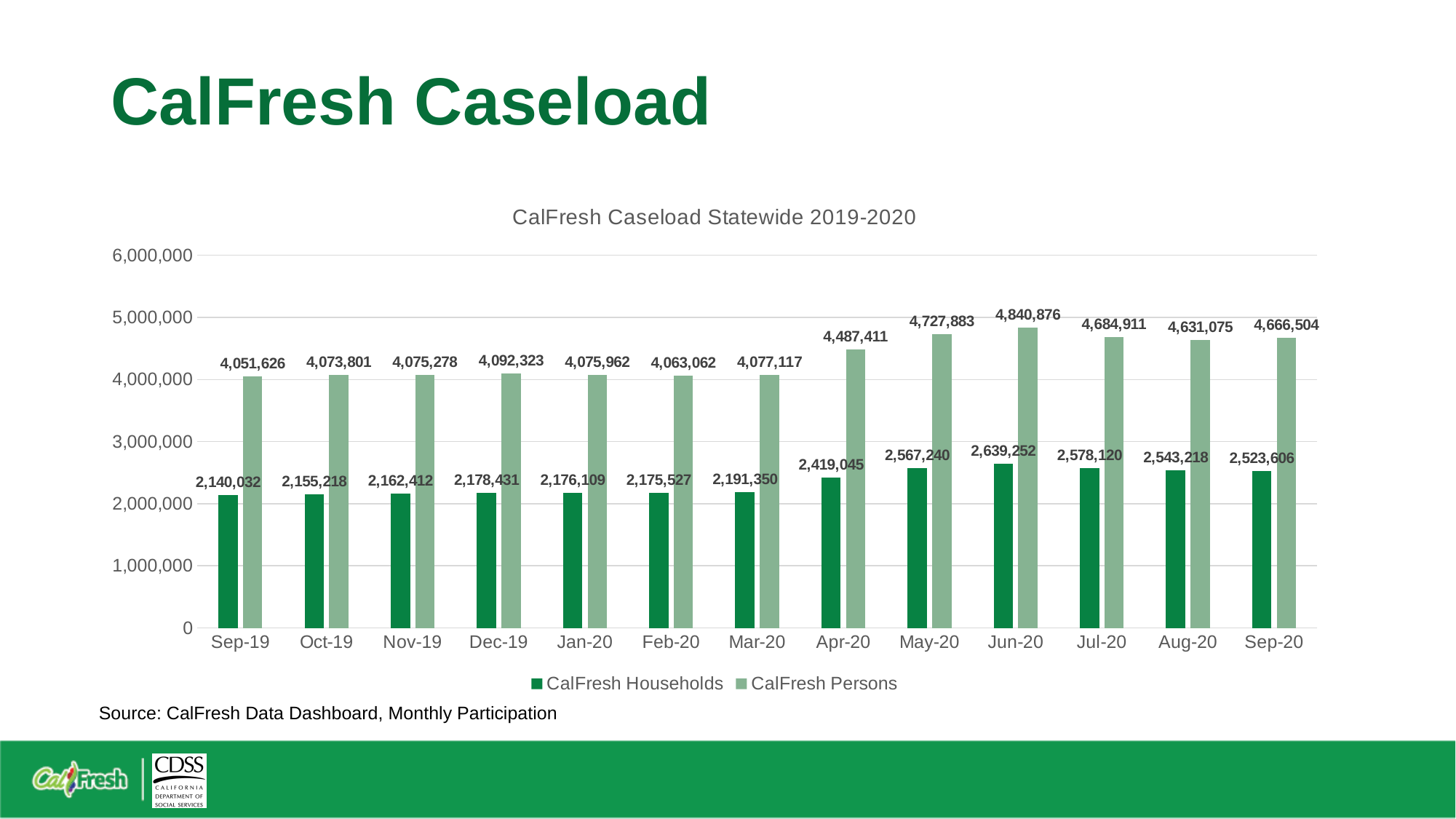
What is the value for CalFresh Households in Apr-20? 2,419,045 What is the title of the chart? CalFresh Caseload Statewide 2019-2020 What kind of chart is shown on the slide? Bar chart What is the value for CalFresh Persons in Jun-20? 4,840,876 How many series does the legend list? 2 Which month has the lowest value for CalFresh Households? Sep-19 Is the value for CalFresh Persons in Apr-20 greater or less than 4,000,000? greater Which month has the highest value for CalFresh Persons? Jun-20 What is the difference between the CalFresh Persons value in Jun-20 and in Sep-19? 789,250 How many months are shown on the x axis? 13 Which is larger: the CalFresh Households value in May-20 or in Sep-20? May-20 What is the value for CalFresh Households in Sep-19? 2,140,032